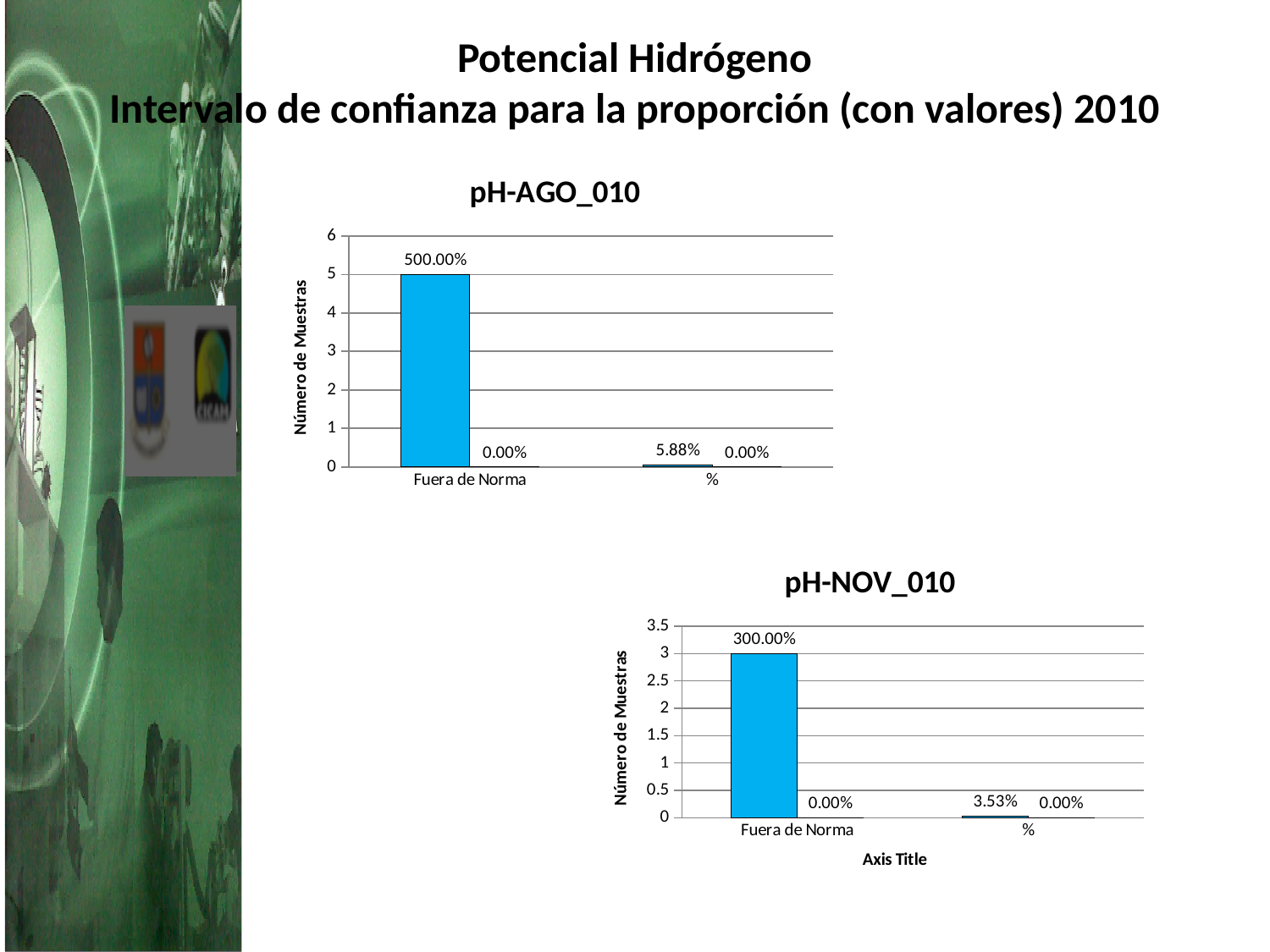
Which chart has the taller Fuera de Norma bar, pH-AGO_010 or pH-NOV_010? pH-AGO_010 In the pH-NOV_010 chart, which category has the tallest bar? Fuera de Norma In the pH-NOV_010 chart, is the tall blue bar for Fuera de Norma greater or less than 2 on the y axis? greater In the pH-AGO_010 chart, what is the data label on the tall blue bar for Fuera de Norma? 500.00% In the pH-AGO_010 chart, what is the data label on the first bar of the % category? 5.88% What kind of chart is pH-AGO_010? Bar chart In the pH-NOV_010 chart, what is the data label on the first bar of the % category? 3.53% In the pH-AGO_010 chart, is the tall blue bar for Fuera de Norma greater or less than 4 on the y axis? greater What is the y-axis title of the pH-NOV_010 chart? Número de Muestras In the pH-NOV_010 chart, what is the data label on the tall blue bar for Fuera de Norma? 300.00% In the pH-AGO_010 chart, which category has the tallest bar? Fuera de Norma How many categories are shown on the x axis of the pH-NOV_010 chart? 2